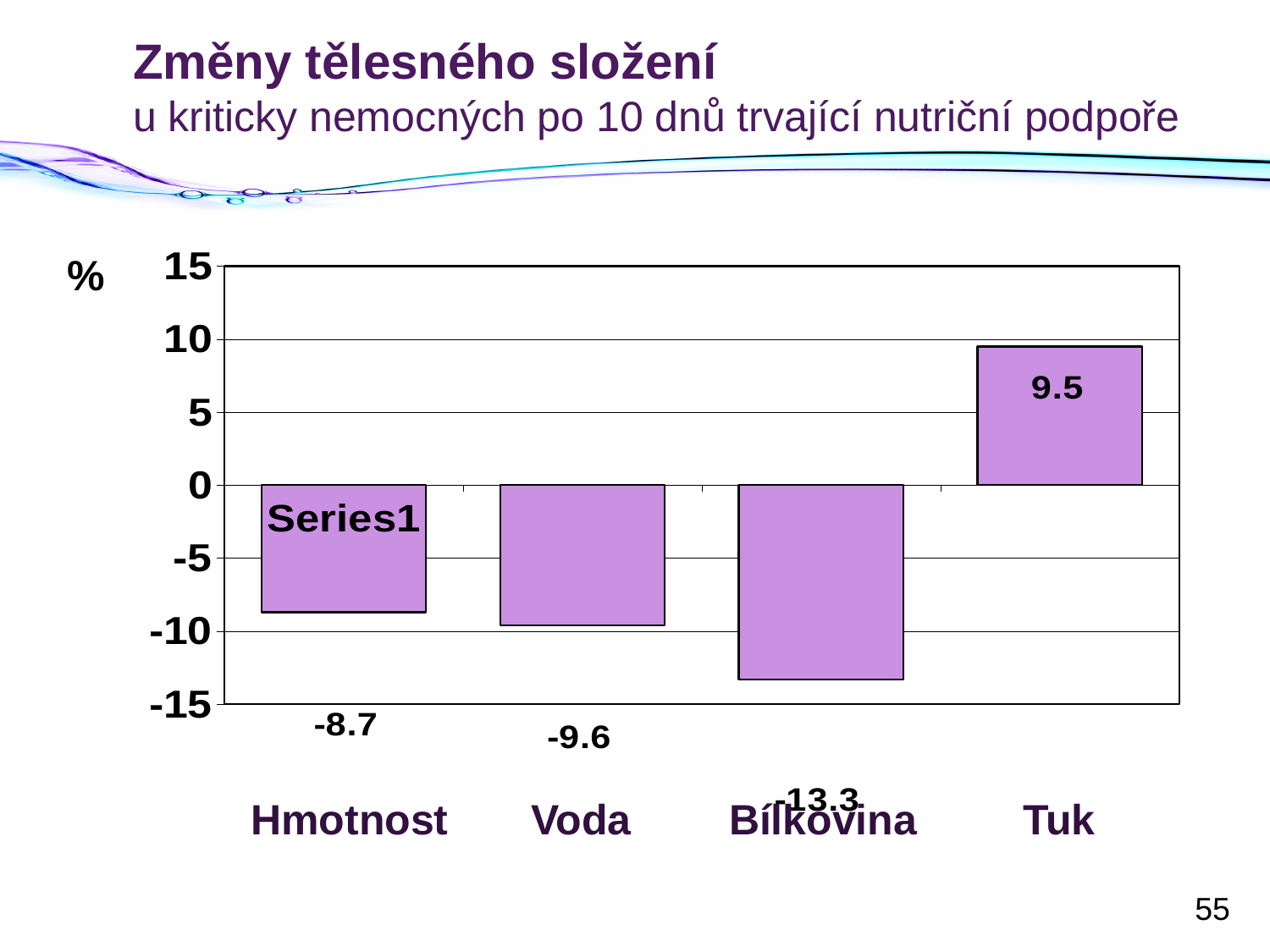
What is the difference between the values for Tuk and Hmotnost? 18.2 Which category has the highest value? Tuk Which is larger, the value for Hmotnost or the value for Voda? Hmotnost What is the value for Tuk? 9.5 How many categories are shown on the x axis? 4 What kind of chart is shown on the slide? Bar chart What is the value for Voda? -9.6 What is the value for Bílkovina? -13.3 What is the value for Hmotnost? -8.7 What is the difference between the values for Voda and Bílkovina? 3.7 Which category has the lowest value? Bílkovina What unit is shown on the y axis label? %